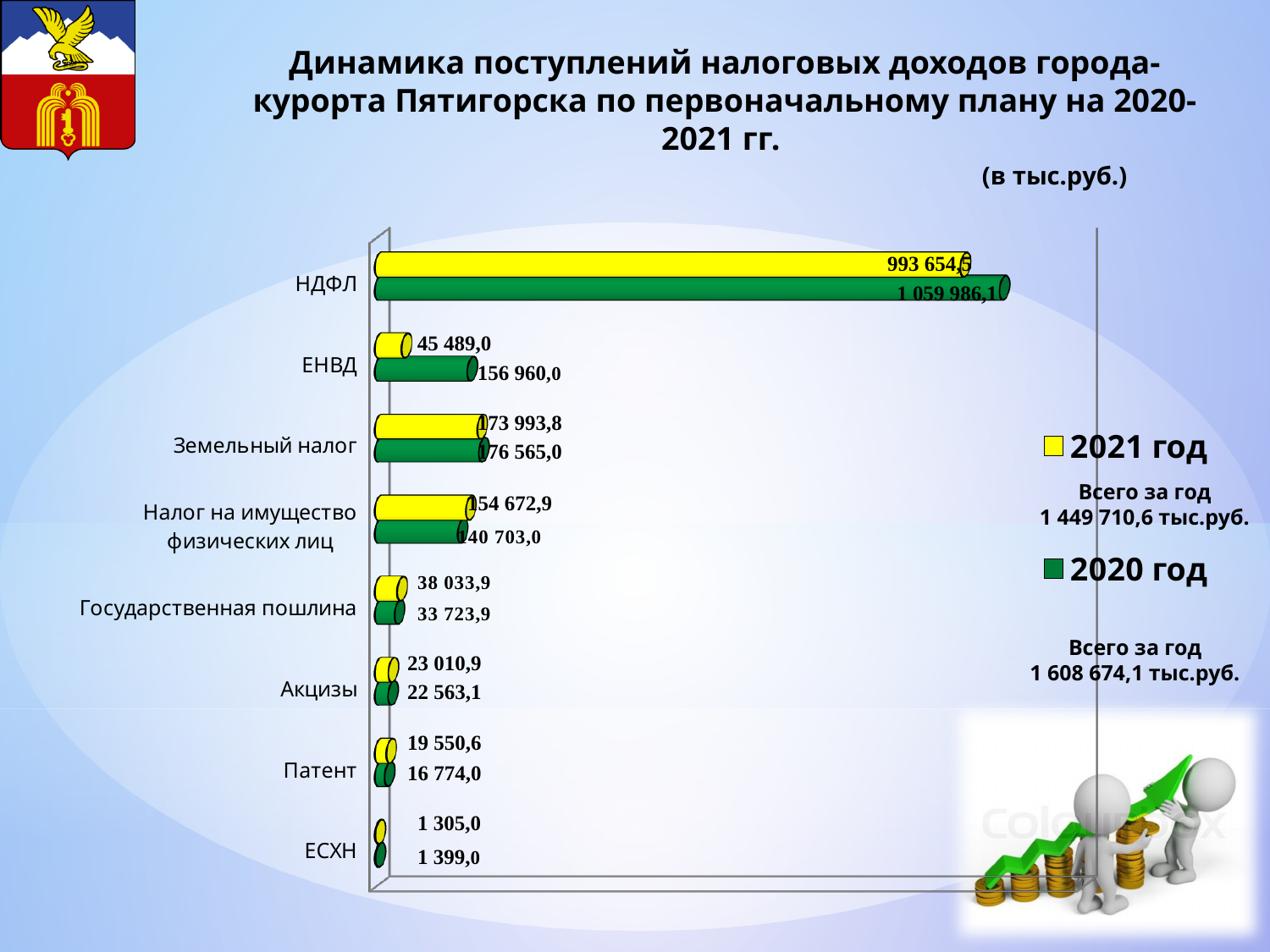
Which category has the highest value in the 2020 год series? НДФЛ What is the value for ЕНВД in the 2020 год series? 156 960,0 Which category has the lowest value in the 2021 год series? ЕСХН What total for the year is given next to the 2021 год legend entry? 1 449 710,6 тыс.руб. What is the value for Патент in the 2020 год series? 16 774,0 For ЕНВД, which series has the larger value, 2021 год or 2020 год? 2020 год How many categories are shown on the chart? 8 What is the difference between the 2021 год and 2020 год values for Государственная пошлина? 4 310,0 What kind of chart is shown on the slide? Bar chart What is the value for НДФЛ in the 2020 год series? 1 059 986,1 What is the value for Государственная пошлина in the 2021 год series? 38 033,9 How many series does the legend list? 2